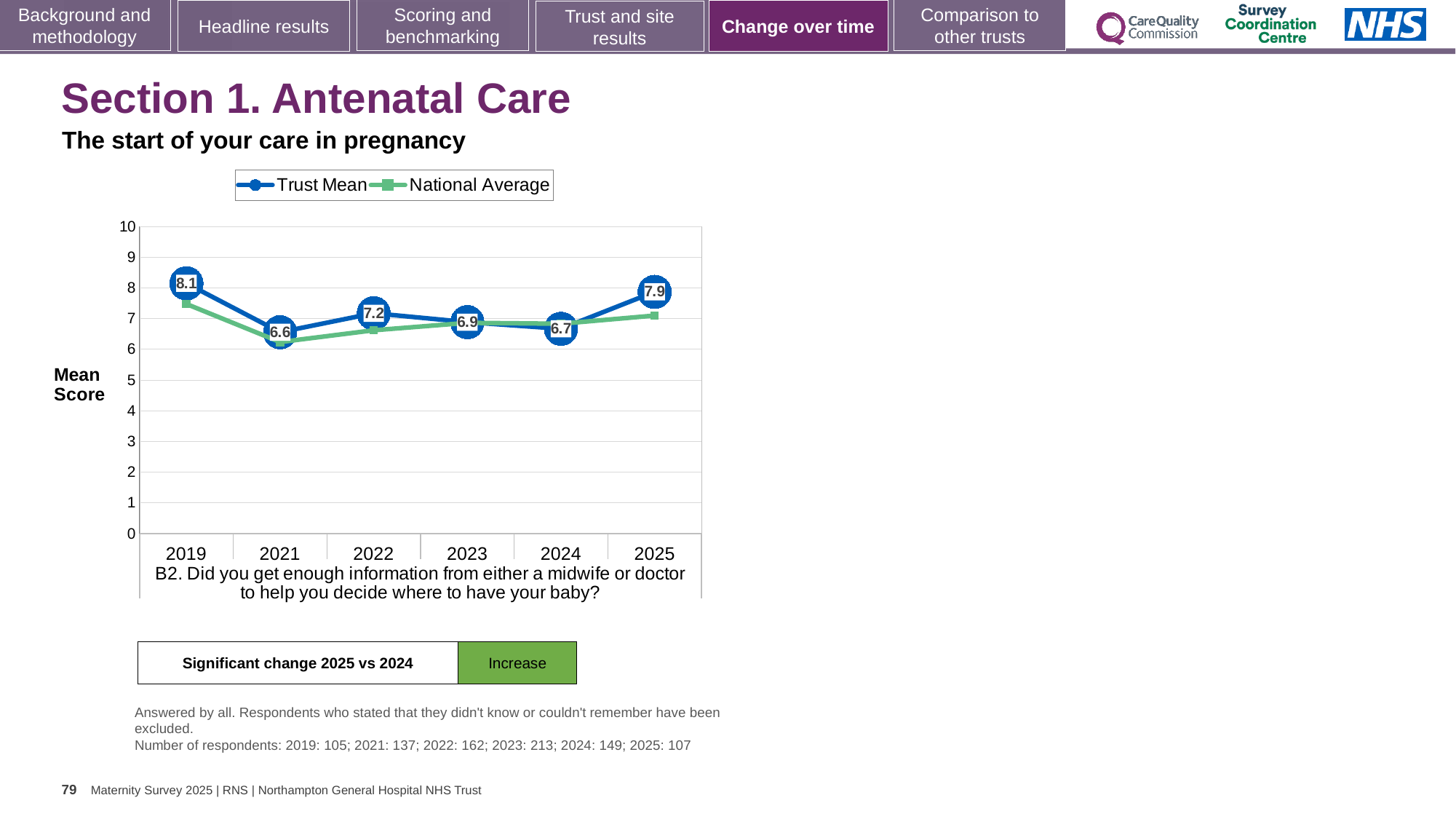
Is the National Average for 2019 greater or less than 7? greater Which year has the lowest Trust Mean? 2021 What is the Trust Mean for 2019? 8.1 How many series does the legend list? 2 How many years are shown on the x axis? 6 What is the Trust Mean for 2025? 7.9 Does the Trust Mean rise or fall from 2024 to 2025? rise What kind of chart is shown? line chart What is the Trust Mean for 2022? 7.2 Which year has the highest Trust Mean? 2019 Which is larger, the Trust Mean in 2022 or in 2023? 2022 What is the difference between the Trust Mean in 2025 and in 2024? 1.2